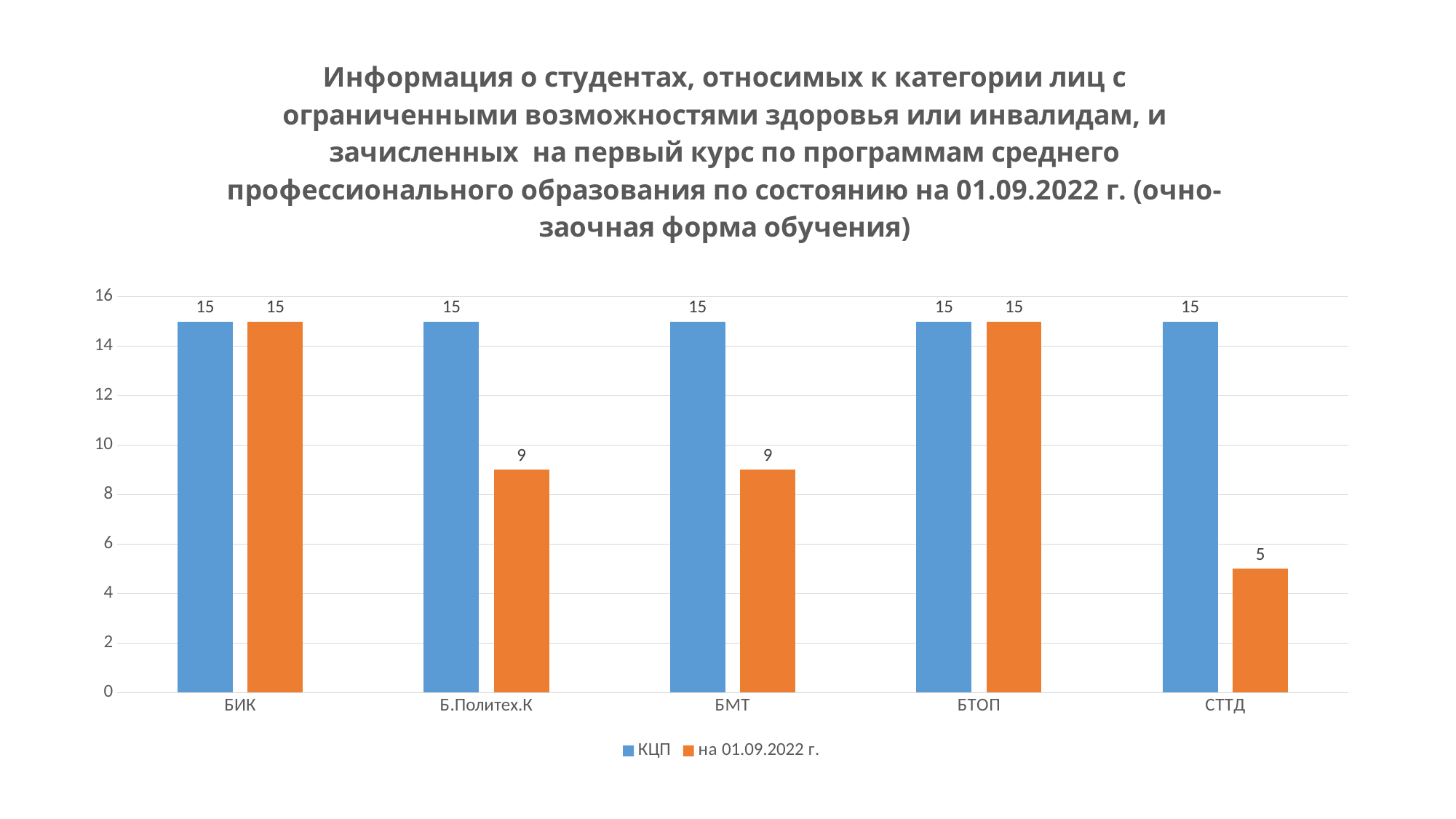
How many series does the legend list? 2 How many categories are shown on the x axis? 5 What is the value for КЦП for БИК? 15 What is the difference between КЦП and на 01.09.2022 г. for Б.Политех.К? 6 What is the value for на 01.09.2022 г. for СТТД? 5 Which category has the lowest value for на 01.09.2022 г.? СТТД What is the value for на 01.09.2022 г. for БМТ? 9 Which is larger for БМТ: КЦП or на 01.09.2022 г.? КЦП What is the difference between КЦП and на 01.09.2022 г. for СТТД? 10 Is the value for на 01.09.2022 г. for СТТД greater or less than 10? less What kind of chart is shown on the slide? bar chart What is the value for на 01.09.2022 г. for Б.Политех.К? 9